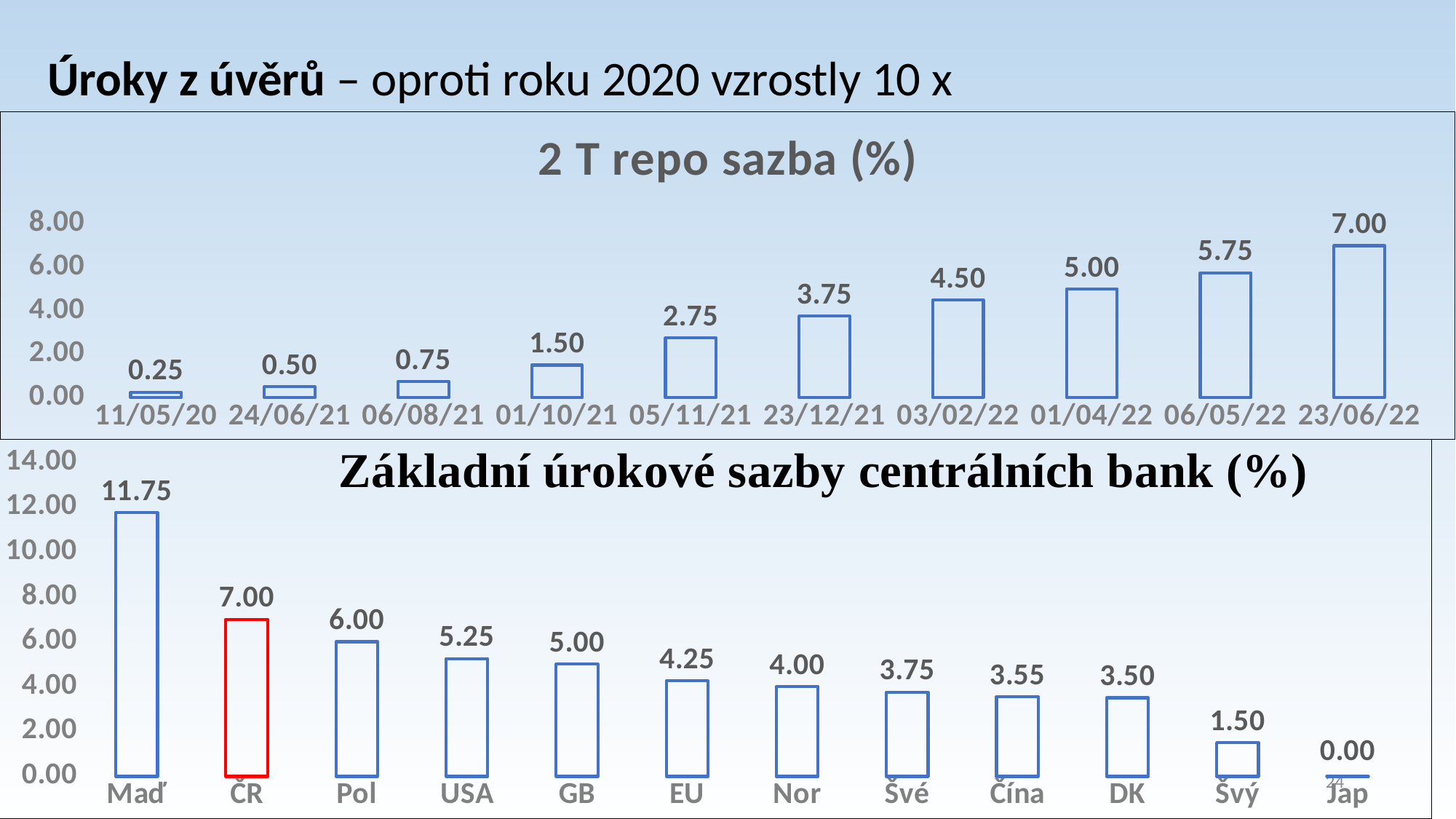
In the 'Základní úrokové sazby centrálních bank (%)' chart, which country has the lowest value? Jap In the '2 T repo sazba (%)' chart, do the values rise or fall from left to right along the x axis? rise In the '2 T repo sazba (%)' chart, which date has the lowest value? 11/05/20 In the 'Základní úrokové sazby centrálních bank (%)' chart, what is the value for USA? 5.25 In the 'Základní úrokové sazby centrálních bank (%)' chart, which is larger, the value for Pol or the value for GB? Pol In the '2 T repo sazba (%)' chart, what is the difference between the values for 23/06/22 and 11/05/20? 6.75 What kind of chart is the 'Základní úrokové sazby centrálních bank (%)' chart? bar chart In the '2 T repo sazba (%)' chart, which date has the highest value? 23/06/22 In the '2 T repo sazba (%)' chart, what is the value for 05/11/21? 2.75 In the 'Základní úrokové sazby centrálních bank (%)' chart, what is the difference between the values for Maď and ČR? 4.75 In the '2 T repo sazba (%)' chart, how many dates are shown on the x axis? 10 In the 'Základní úrokové sazby centrálních bank (%)' chart, which country has the highest value? Maď